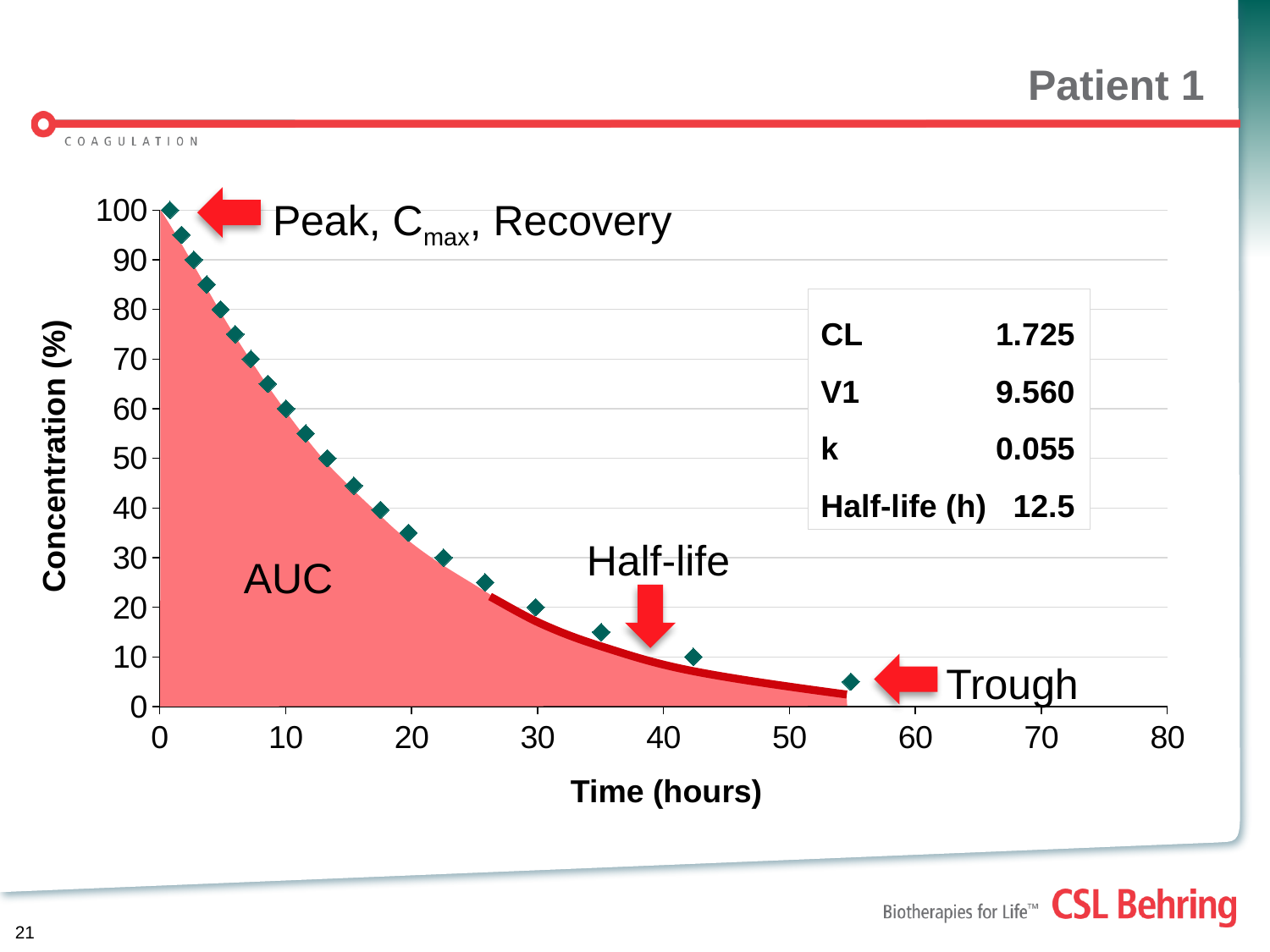
What kind of chart is shown on the slide? scatter chart What is the label of the y axis? Concentration (%) Which is larger, the concentration at 10 hours or at 30 hours? 10 hours Is the concentration at 30 hours greater or less than 30? less Is the concentration at about 55 hours greater or less than 10? less Is the concentration at 10 hours greater or less than 60? greater Does the concentration rise or fall as time increases? fall What is the concentration (%) at time 0 hours? 100 At what time (hours) is the concentration highest? 0 What is the label of the x axis? Time (hours)